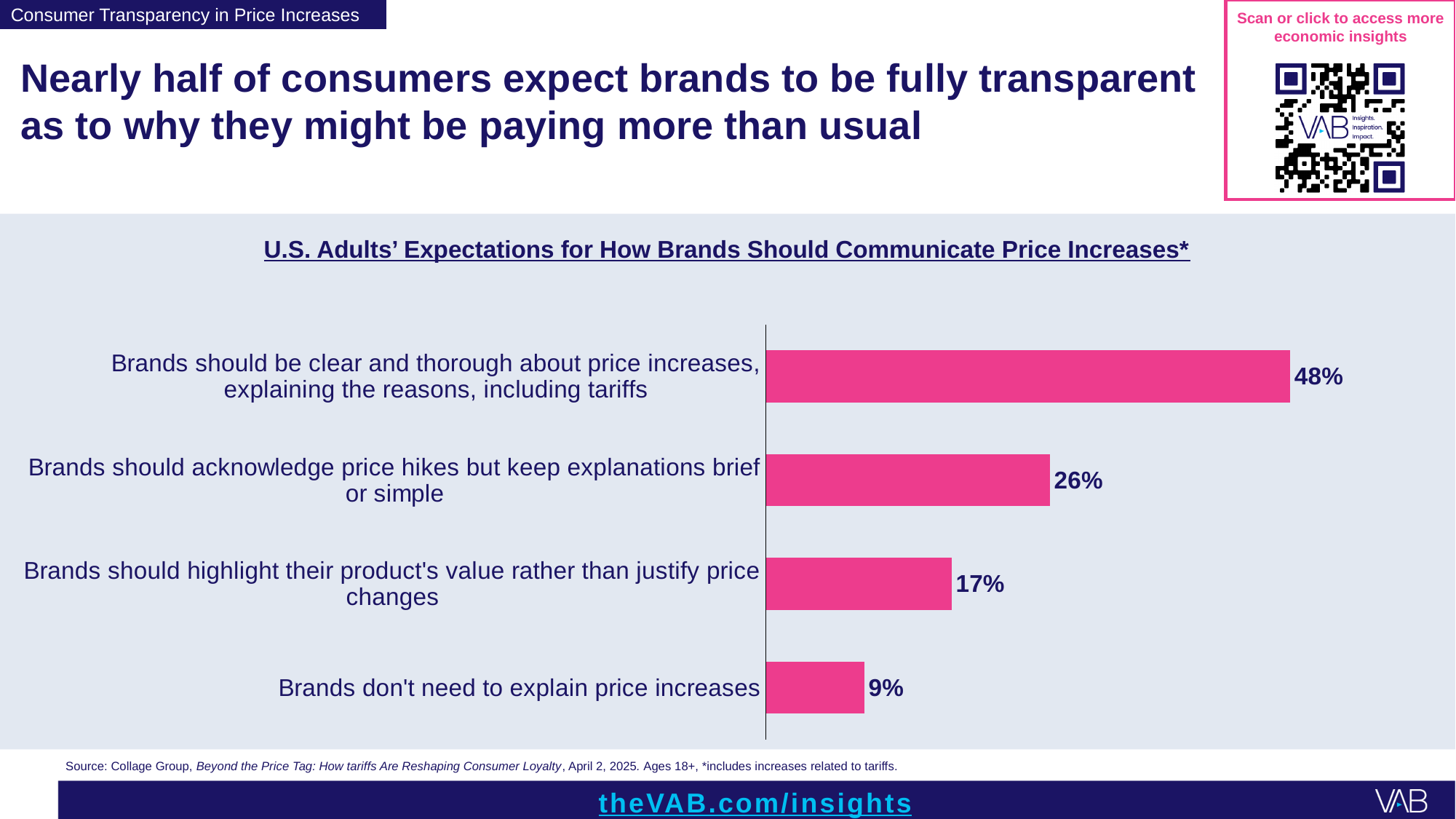
What type of chart is shown on the slide? Bar chart Which expectation has the lowest percentage in the chart? Brands don't need to explain price increases What is the difference in percentage points between 'Brands should highlight their product's value rather than justify price changes' and 'Brands don't need to explain price increases'? 8 percentage points What percentage of U.S. adults say brands don't need to explain price increases? 9% Which expectation has the highest percentage in the chart? Brands should be clear and thorough about price increases, explaining the reasons, including tariffs What percentage of U.S. adults say brands should acknowledge price hikes but keep explanations brief or simple? 26% What percentage of U.S. adults say brands should highlight their product's value rather than justify price changes? 17% What is the title of the chart? U.S. Adults' Expectations for How Brands Should Communicate Price Increases* What is the difference in percentage points between 'Brands should be clear and thorough about price increases' and 'Brands should acknowledge price hikes but keep explanations brief or simple'? 22 percentage points Which is larger: the percentage for 'Brands should acknowledge price hikes but keep explanations brief or simple' or for 'Brands should highlight their product's value rather than justify price changes'? Brands should acknowledge price hikes but keep explanations brief or simple What percentage of U.S. adults say brands should be clear and thorough about price increases, explaining the reasons, including tariffs? 48% How many categories are shown in the chart? 4